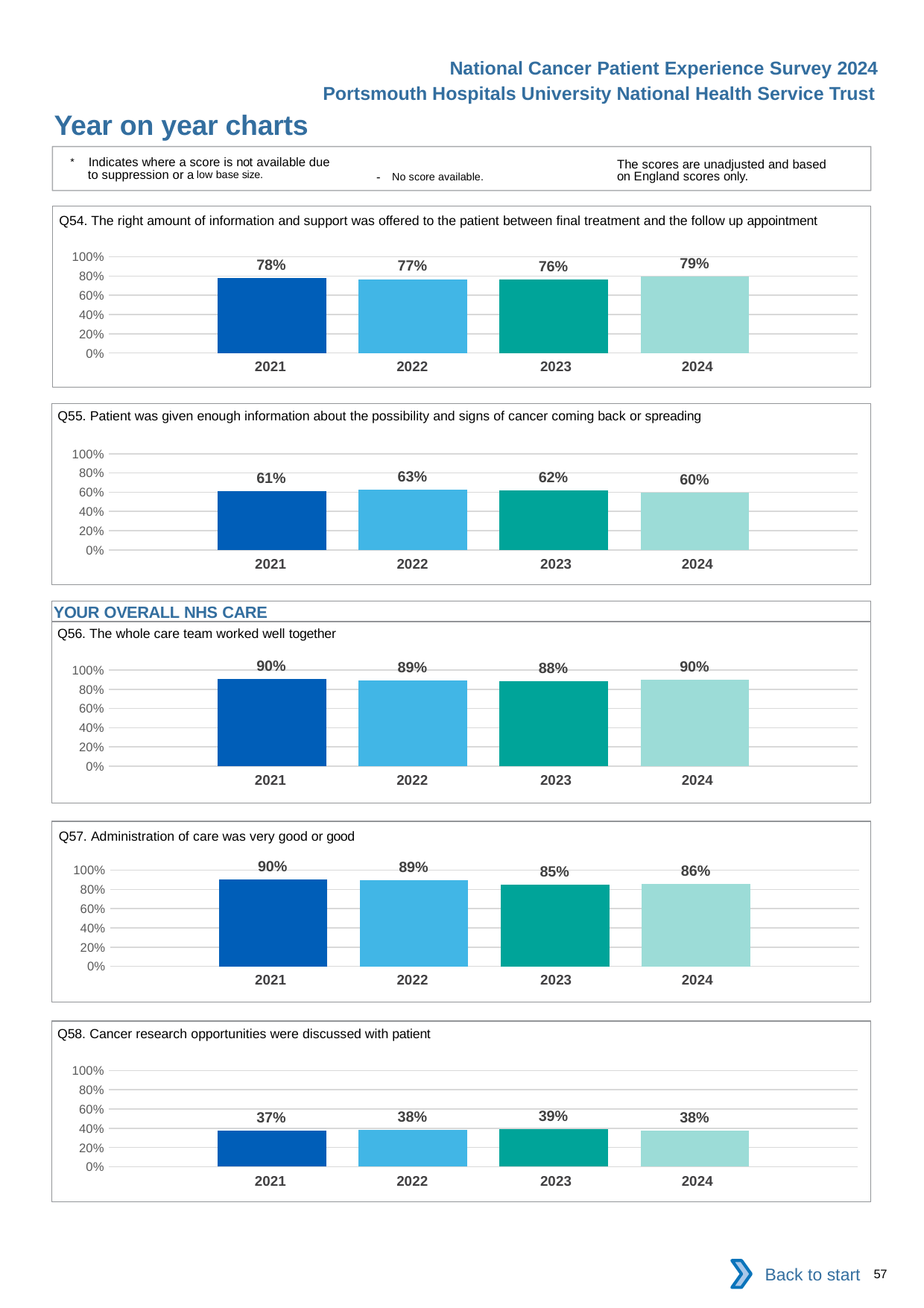
In the Q55 chart, which year has the lowest value? 2024 In the Q57 chart, what is the difference between the 2021 value and the 2023 value? 5% In the Q57 chart, which year has the highest value? 2021 In the Q58 chart, which is larger, the value for 2021 or the value for 2023? 2023 In the Q58 chart, is the value for 2024 greater or less than 60%? less In the Q54 chart, which year has the lowest value? 2023 What kind of chart is the Q56 chart? bar chart In the Q56 chart, what is the value for 2023? 88% In the Q54 chart, what is the value for 2024? 79% In the Q55 chart, what is the difference between the 2022 value and the 2024 value? 3% In the Q55 chart, what is the value for 2022? 63% How many years are shown in the Q58 chart? 4